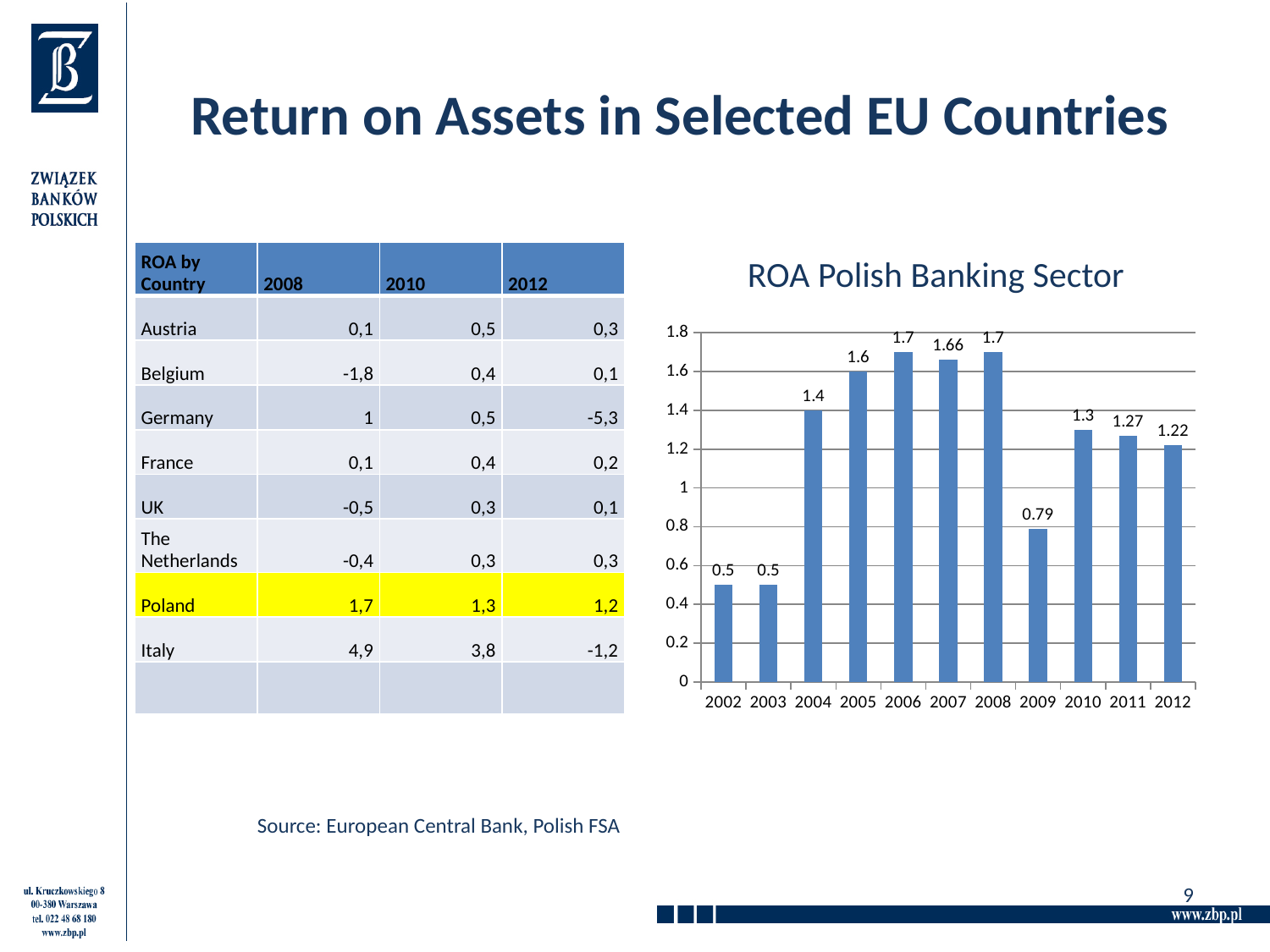
In the ROA Polish Banking Sector chart, what is the value for 2007? 1.66 In the ROA Polish Banking Sector chart, what is the value for 2012? 1.22 In the ROA Polish Banking Sector chart, which year has the larger value, 2005 or 2010? 2005 In the ROA Polish Banking Sector chart, what is the value for 2009? 0.79 In the ROA Polish Banking Sector chart, how many years are plotted on the x axis? 11 What type of chart is shown under the title 'ROA Polish Banking Sector'? bar chart In the ROA Polish Banking Sector chart, do the values rise or fall from 2010 to 2012? fall In the ROA Polish Banking Sector chart, what is the value for 2004? 1.4 In the ROA Polish Banking Sector chart, is the value for 2009 greater or less than 1? less In the ROA Polish Banking Sector chart, what is the difference between the values for 2008 and 2009? 0.91 What is the title of the chart on the slide? ROA Polish Banking Sector In the ROA Polish Banking Sector chart, what is the difference between the values for 2010 and 2012? 0.08